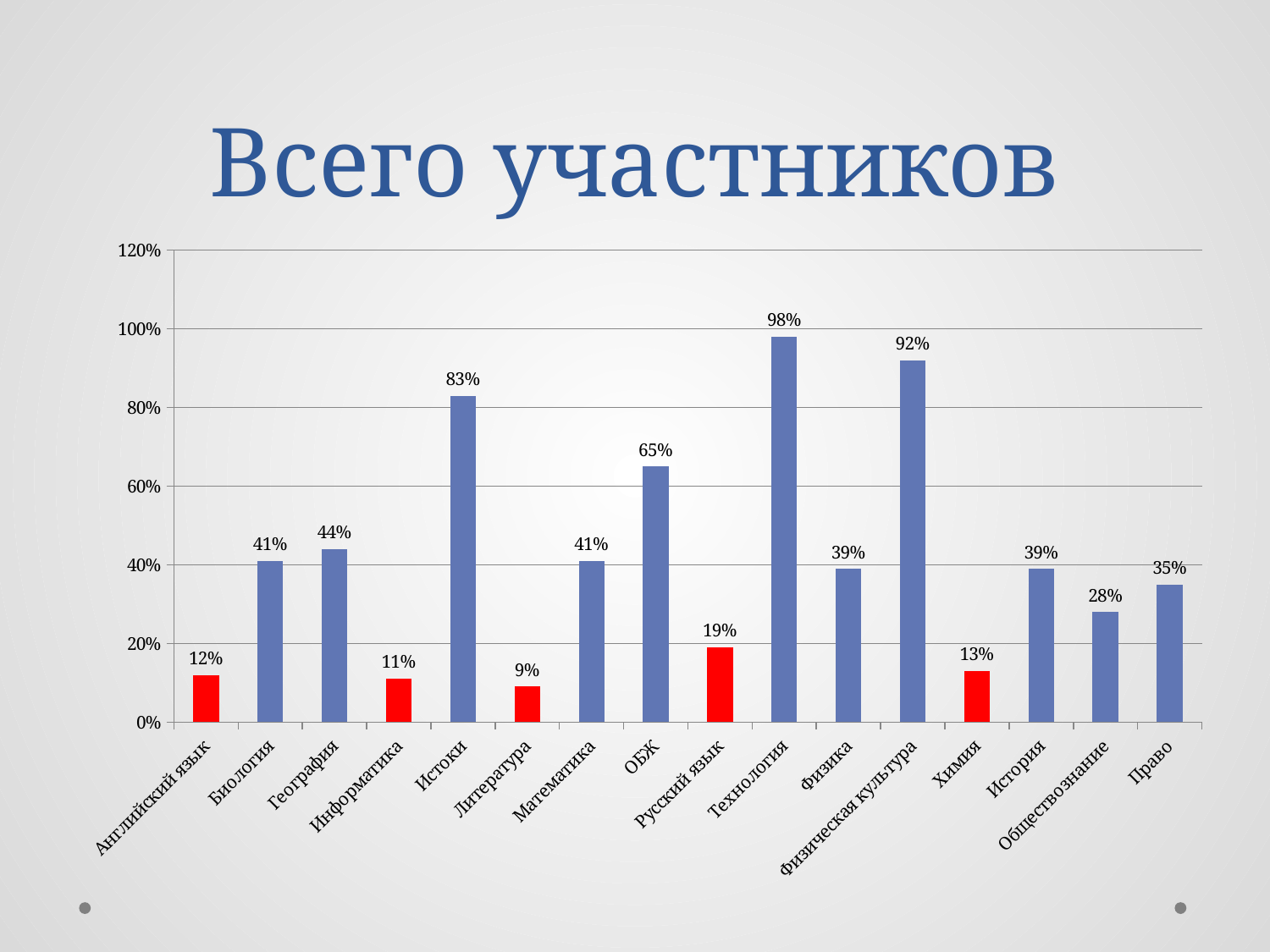
How many bars are coloured red? 4 What is the difference between the values for Физическая культура and ОБЖ? 27% What kind of chart is shown on the slide? bar chart Which is larger, the value for География or the value for Право? География Is the value for Физика greater or less than 40%? less Which category has the highest value? Технология What is the title of the slide? Всего участников What is the value for Технология? 98% How many categories are shown on the x axis? 16 What is the value for Истоки? 83% What is the value for Обществознание? 28% Which category has the lowest value? Литература